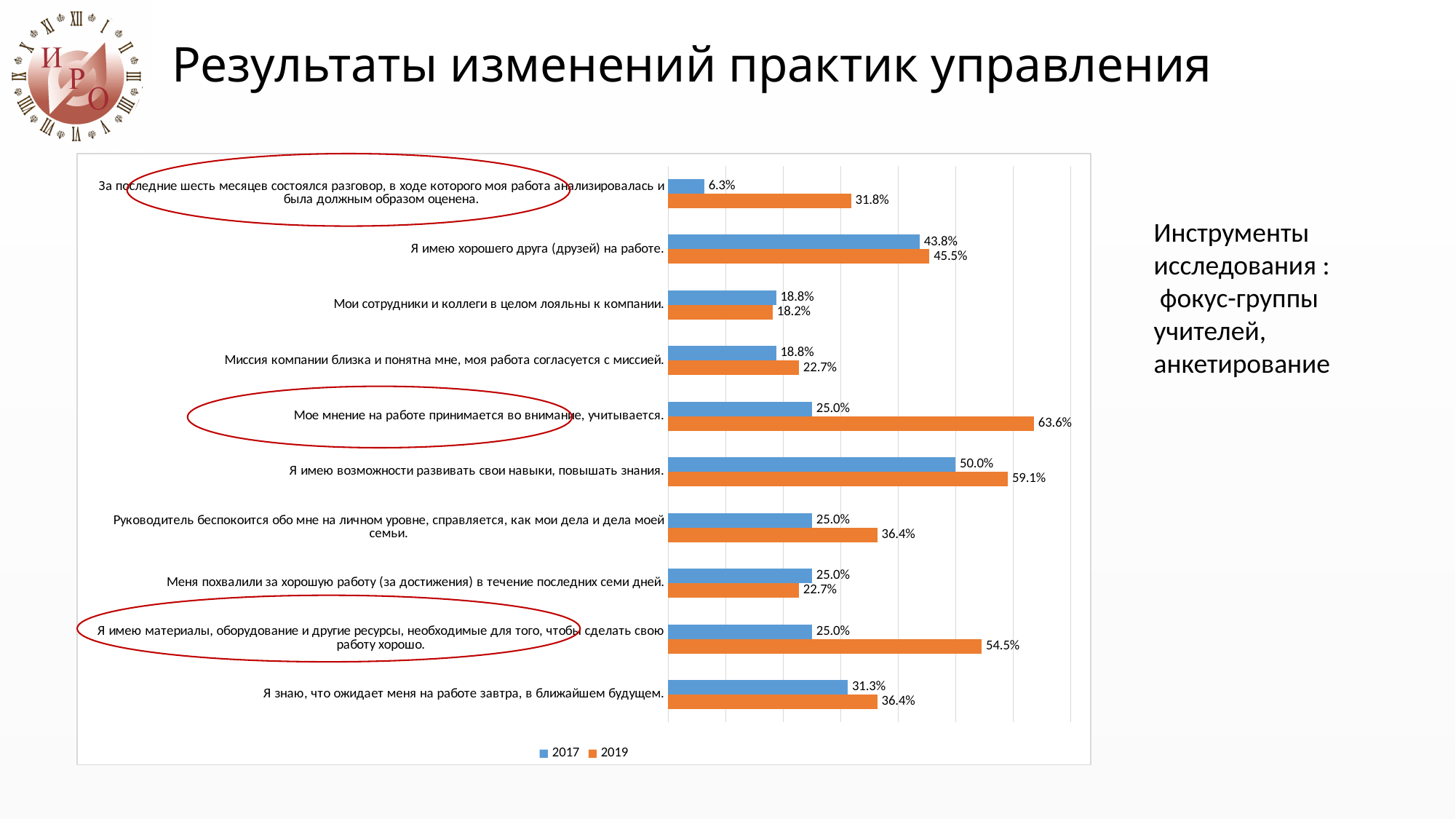
Which statement has the highest 2017 value? Я имею возможности развивать свои навыки, повышать знания. What is the difference between the 2019 and 2017 values for "Мое мнение на работе принимается во внимание, учитывается."? 38.6 percentage points What is the 2017 value for "За последние шесть месяцев состоялся разговор, в ходе которого моя работа анализировалась и была должным образом оценена."? 6.3% Which statement has the highest 2019 value? Мое мнение на работе принимается во внимание, учитывается. Which statement has the lowest 2017 value? За последние шесть месяцев состоялся разговор, в ходе которого моя работа анализировалась и была должным образом оценена. How many categories (statements) are plotted in the chart? 10 Which colour represents the 2019 series in the chart? Orange For "Меня похвалили за хорошую работу (за достижения) в течение последних семи дней.", which year has the larger value, 2017 or 2019? 2017 What is the 2019 value for "Я имею материалы, оборудование и другие ресурсы, необходимые для того, чтобы сделать свою работу хорошо."? 54.5% What kind of chart is shown on the slide? Bar chart How many series does the legend list? 2 What is the 2019 value for "Мое мнение на работе принимается во внимание, учитывается."? 63.6%